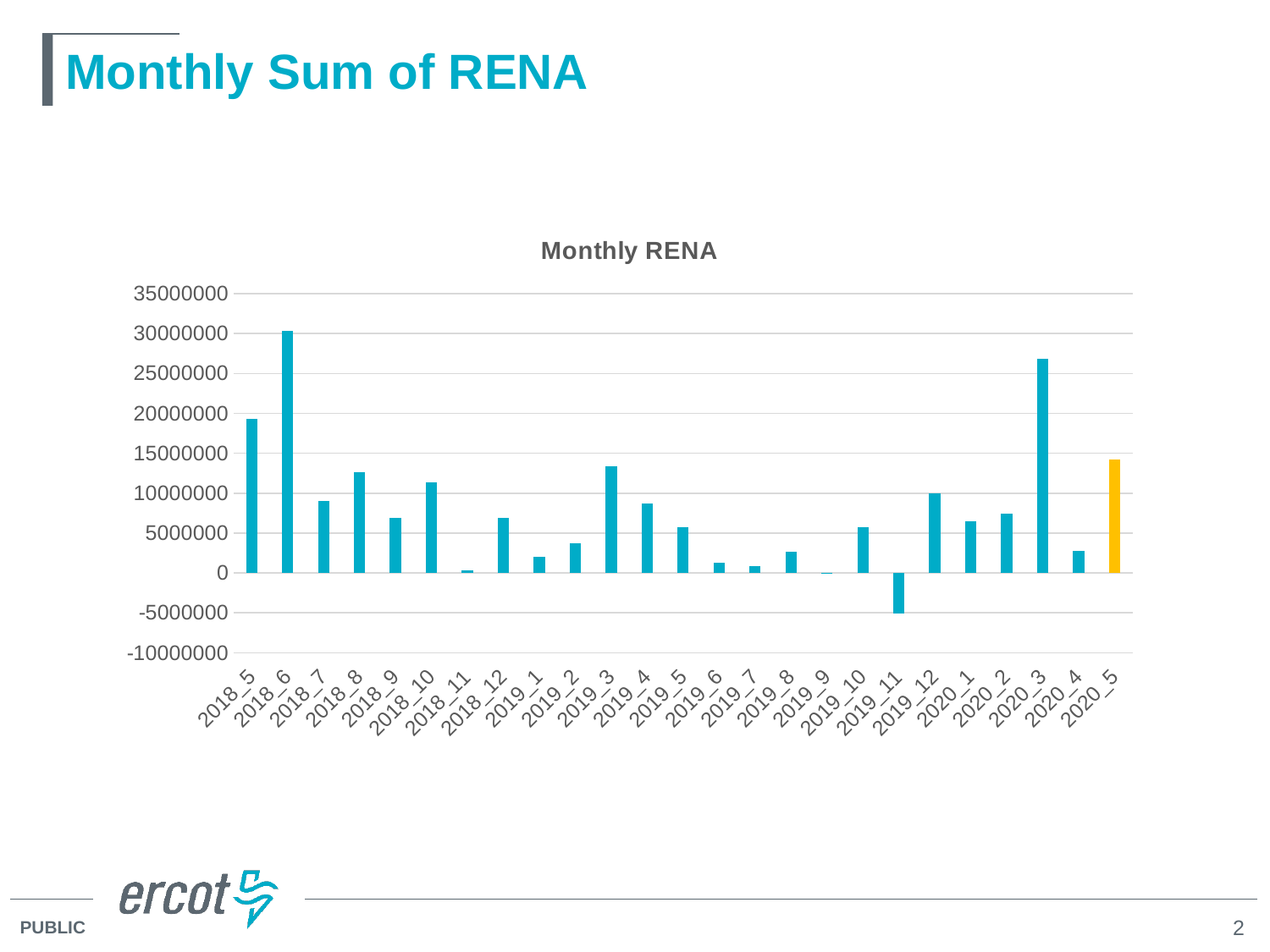
What kind of chart is shown on the slide? bar chart Which month has the lowest Monthly RENA value? 2019_11 Is the value for 2018_5 greater or less than 15000000? greater Is the value for 2020_3 greater or less than 25000000? greater How many months (categories) are plotted on the x axis? 25 Which is larger, the value for 2018_6 or the value for 2020_3? 2018_6 Is the value for 2019_6 greater or less than 5000000? less Which bar is shown in a different colour (yellow) from the rest? 2020_5 Which month has the highest Monthly RENA value? 2018_6 What is the title of the chart? Monthly RENA Which is larger, the value for 2019_3 or the value for 2019_4? 2019_3